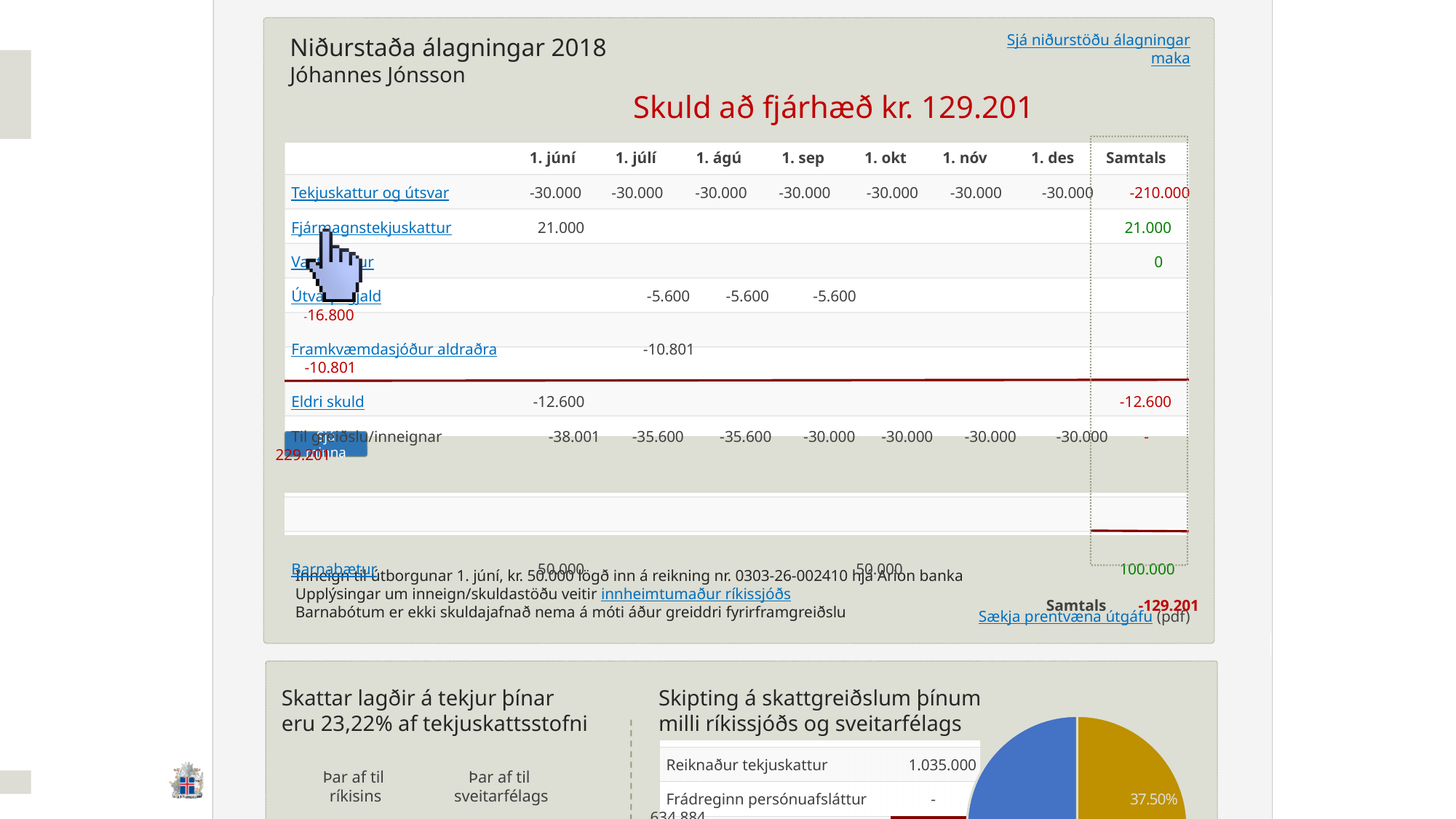
In the pie chart at the bottom right, what percentage is printed on the gold slice? 37.50% In the pie chart at the bottom right, which slice is larger, the blue one or the gold one? blue In the pie chart at the bottom right, what colour is the slice labelled 37.50%? gold In the pie chart at the bottom right, is the share of the gold slice greater or less than 50%? less What kind of chart is shown at the bottom right of the slide? pie chart